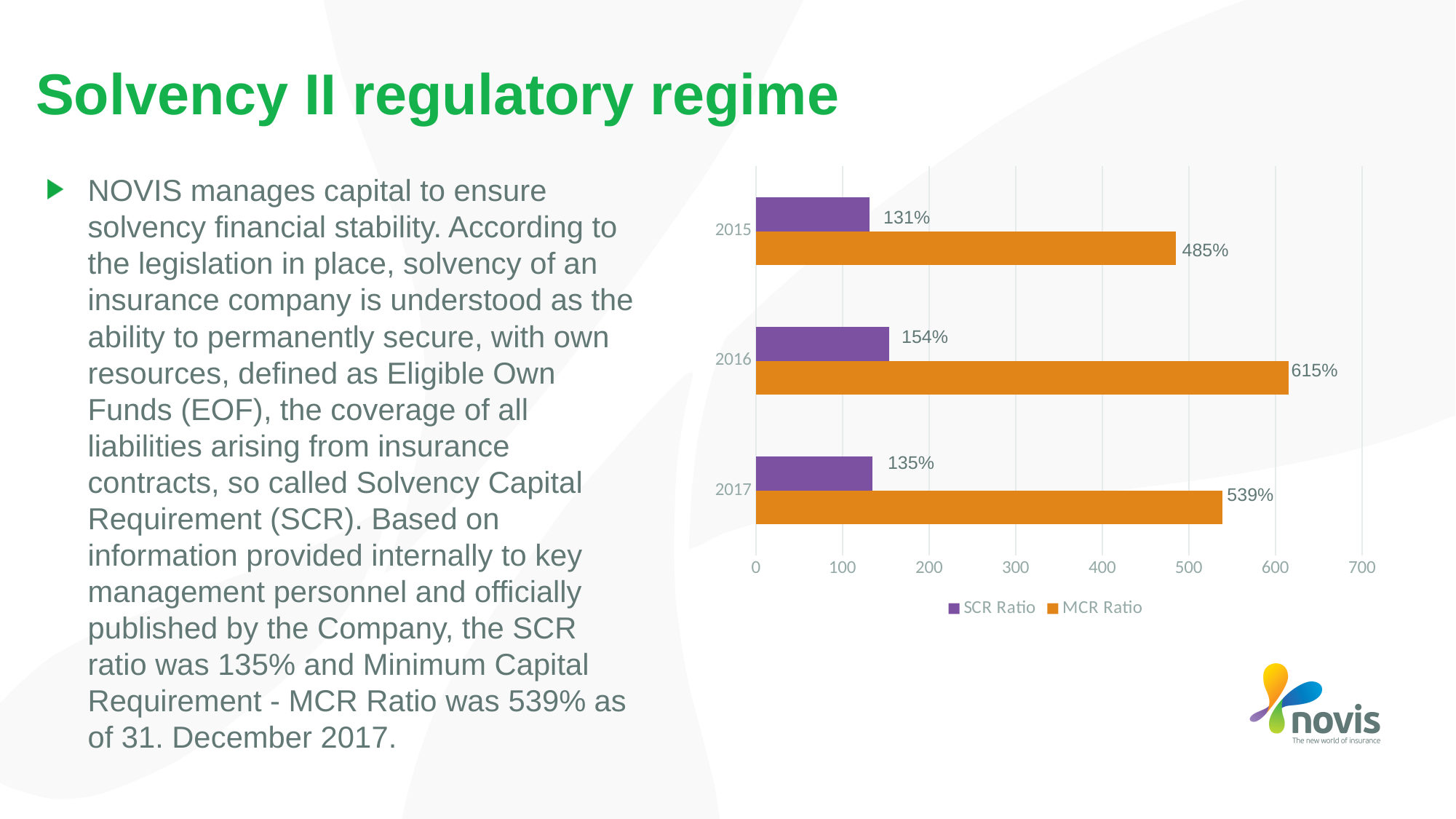
How many years are shown on the chart? 3 What is the difference between the MCR Ratio and the SCR Ratio in 2017? 404% What kind of chart is shown on the slide? Bar chart Which colour represents the MCR Ratio in the chart? Orange How many series does the legend list? 2 Which year has the lowest SCR Ratio? 2015 Which year has the highest MCR Ratio? 2016 What is the MCR Ratio for 2016? 615% Which is larger, the SCR Ratio for 2016 or the SCR Ratio for 2017? SCR Ratio for 2016 What is the SCR Ratio for 2015? 131% What is the MCR Ratio for 2017? 539% Is the MCR Ratio for 2015 greater or less than 400? greater